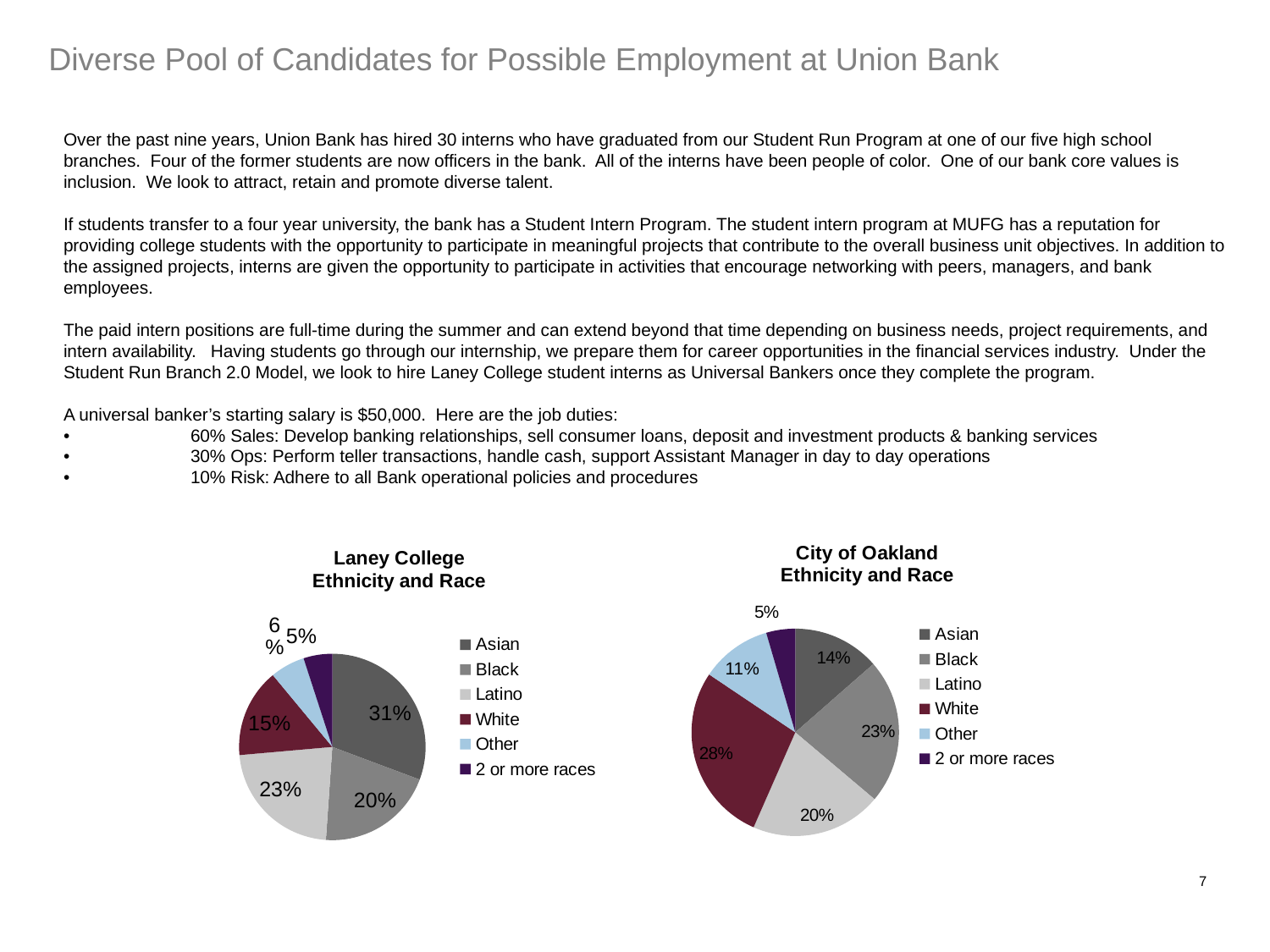
In the City of Oakland Ethnicity and Race chart, which group has the largest share? White In the Laney College Ethnicity and Race chart, what percentage is White? 15% In the Laney College Ethnicity and Race chart, what percentage is Asian? 31% In the City of Oakland Ethnicity and Race chart, what percentage is Other? 11% In the Laney College Ethnicity and Race chart, which group has the largest share? Asian In the City of Oakland Ethnicity and Race chart, what percentage is Asian? 14% In the Laney College Ethnicity and Race chart, what is the difference between the Asian and Black shares? 11% What type of chart is the City of Oakland Ethnicity and Race chart? Pie chart In the City of Oakland Ethnicity and Race chart, what percentage is White? 28% In the City of Oakland Ethnicity and Race chart, which group has the smallest share? 2 or more races In the City of Oakland Ethnicity and Race chart, which is larger, the Black share or the Latino share? Black In the Laney College Ethnicity and Race chart, what percentage is Latino? 23%